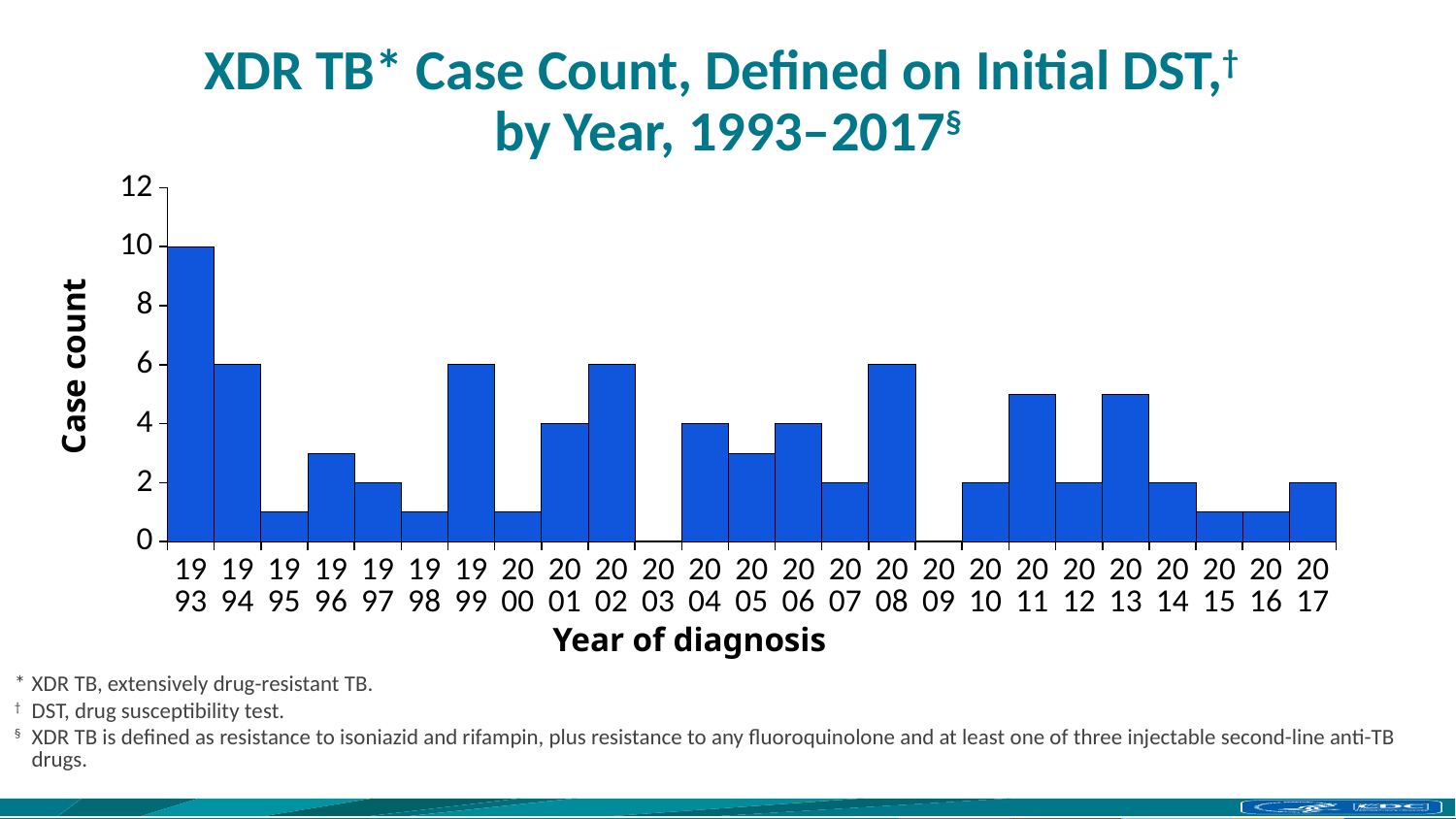
What kind of chart is shown on the slide? bar chart Is the case count for 2015 greater or less than 2? less Which year of diagnosis has the highest case count? 1993 Is the case count for 2011 greater or less than 4? greater What is the case count for 2017? 2 What is the case count for 1993? 10 What is the case count for 2008? 6 How many years of diagnosis are shown on the x axis? 25 What is the case count for 2003? 0 What is the difference between the case counts for 1993 and 1994? 4 Which year has the larger case count, 1999 or 2005? 1999 What is the case count for 2004? 4